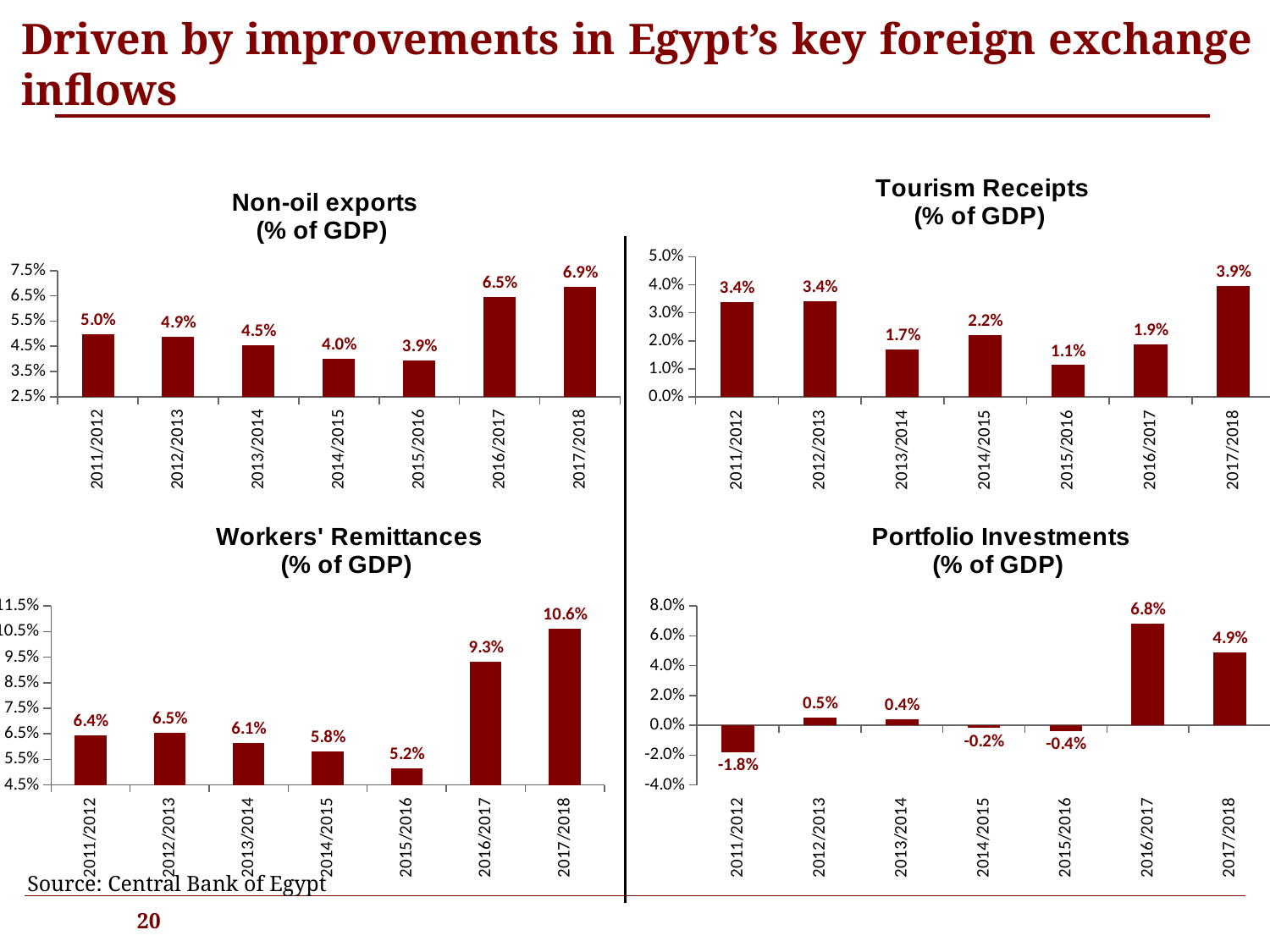
In the Tourism Receipts (% of GDP) chart, what is the value for 2015/2016? 1.1% In the Portfolio Investments (% of GDP) chart, what is the difference between the 2016/2017 value and the 2017/2018 value? 1.9% In the Portfolio Investments (% of GDP) chart, which year has the highest value? 2016/2017 In the Non-oil exports (% of GDP) chart, which year has the lowest value? 2015/2016 In the Workers' Remittances (% of GDP) chart, what is the value for 2016/2017? 9.3% What type of chart is the Workers' Remittances (% of GDP) chart? Bar chart How many years are shown on the x axis of the Non-oil exports (% of GDP) chart? 7 In the Non-oil exports (% of GDP) chart, what is the value for 2017/2018? 6.9% In the Tourism Receipts (% of GDP) chart, what is the difference between the 2017/2018 value and the 2016/2017 value? 2.0% In the Tourism Receipts (% of GDP) chart, which year has the highest value? 2017/2018 In the Workers' Remittances (% of GDP) chart, which is larger, the value for 2012/2013 or the value for 2015/2016? 2012/2013 In the Portfolio Investments (% of GDP) chart, what is the value for 2011/2012? -1.8%